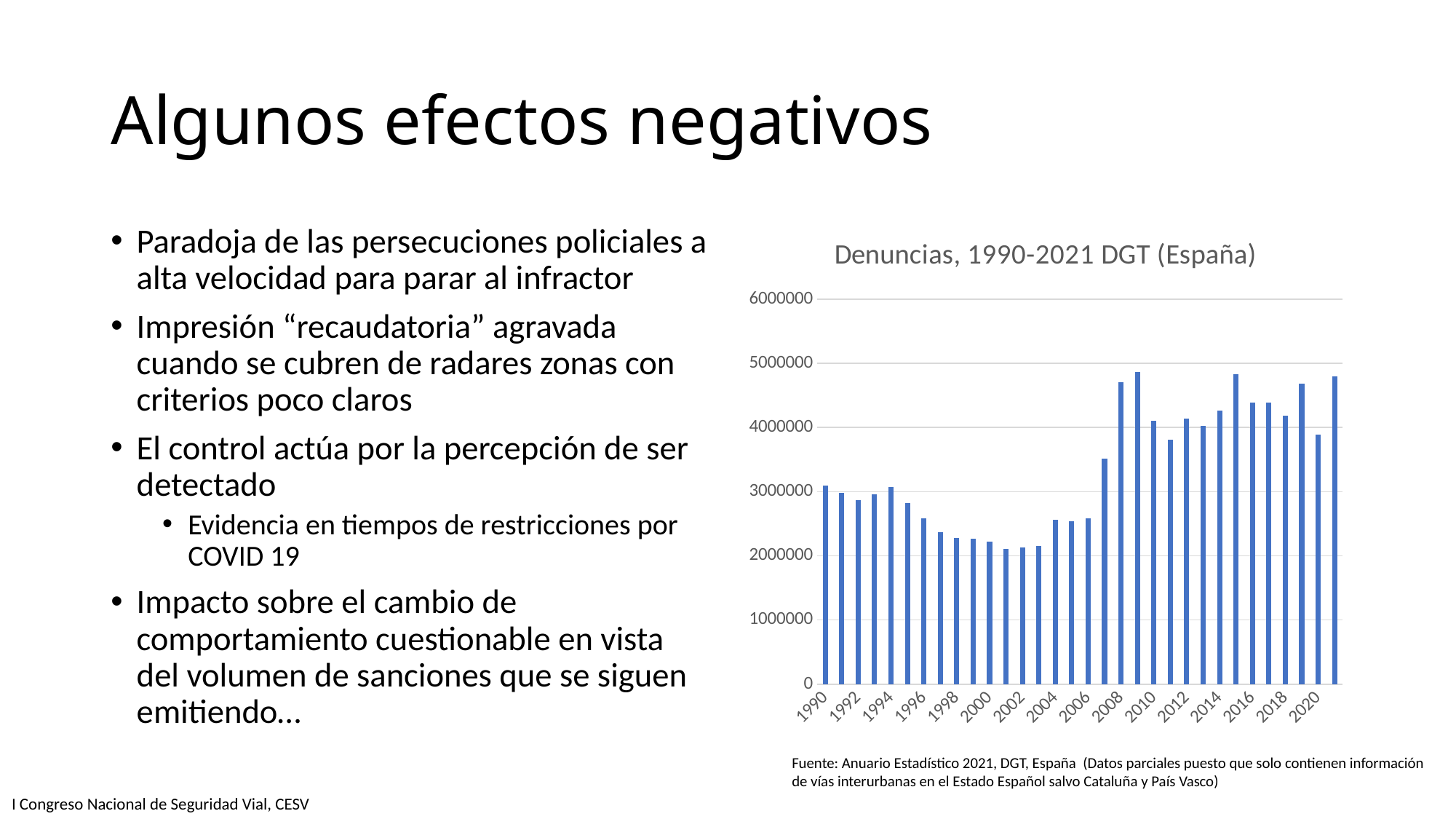
Which year has the larger value, 2008 or 2000? 2008 Is the value for 2008 greater or less than 4000000? greater What is the highest value shown on the vertical axis? 6000000 Is the value for 2016 greater or less than 4000000? greater Is the value for 2020 greater or less than 4000000? less Do the values generally rise or fall from 1990 to 2002? fall How many years (bars) are plotted in the chart? 32 Which year has the larger value, 1990 or 2002? 1990 What is the title of the chart on the slide? Denuncias, 1990-2021 DGT (España) What kind of chart is shown on the slide? bar chart